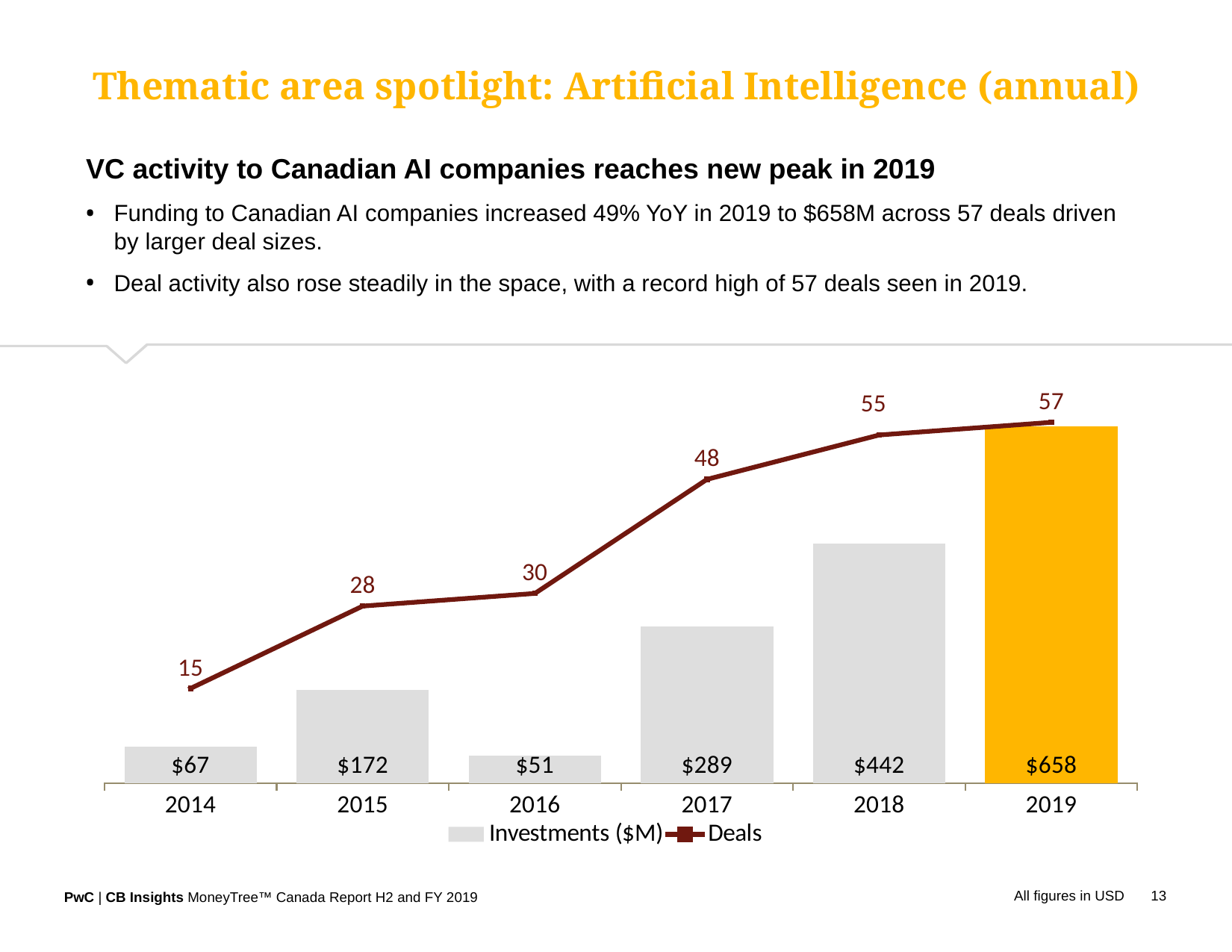
Which year had the lowest investment amount? 2016 How many deals were there in 2016? 30 Which year had more investment, 2015 or 2016? 2015 What is the difference in investments between 2019 and 2018? $216 How many series does the legend list? 2 Do the number of deals rise or fall from 2014 to 2019? rise How many more deals were there in 2017 than in 2016? 18 What was the investment amount in 2017? $289 Which year had the highest investment amount? 2019 Which year had the lowest number of deals? 2014 Which bar is highlighted in a different colour from the others? 2019 How many years are shown on the x axis? 6